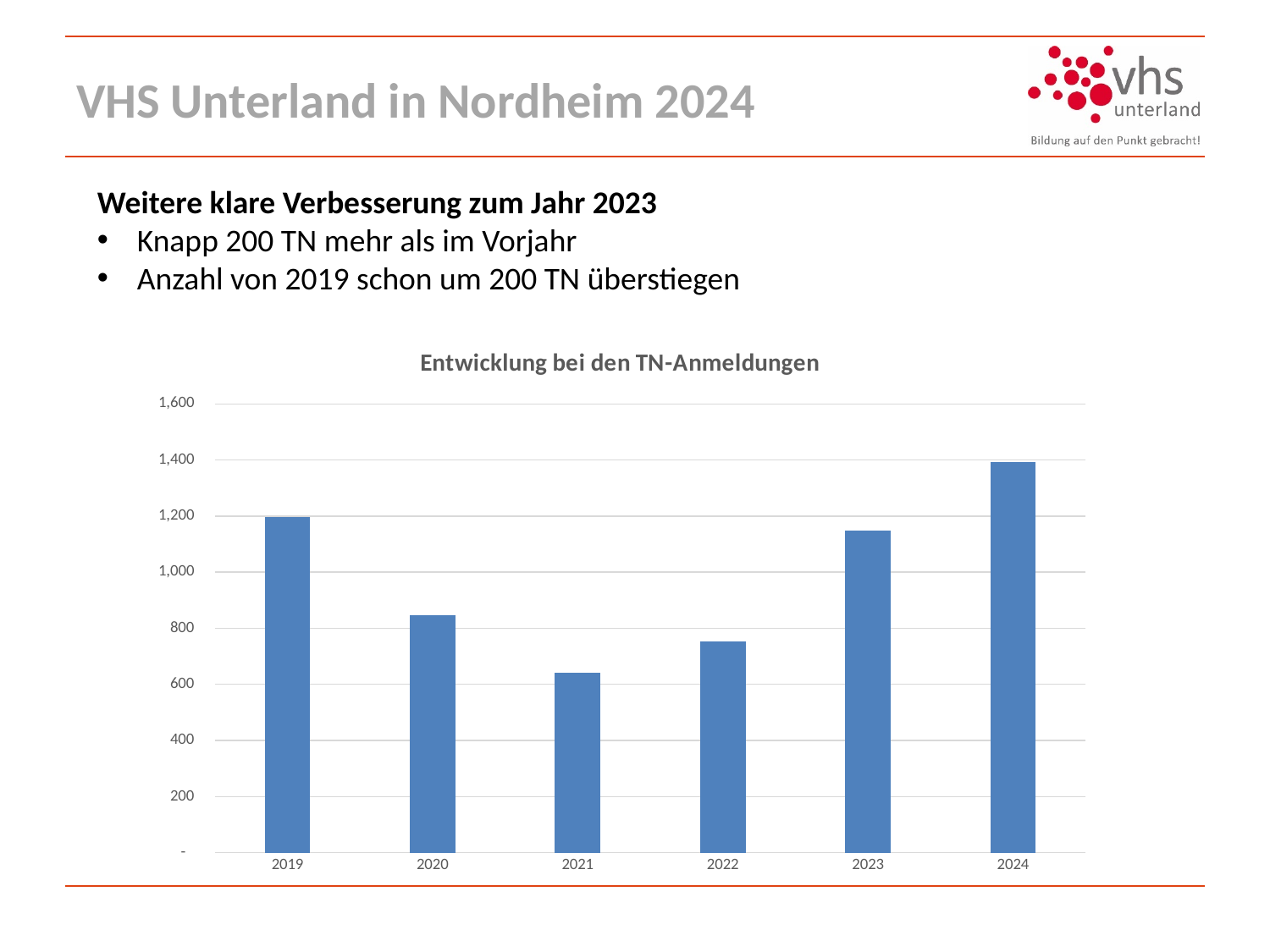
How many years are shown on the x axis of the chart? 6 What is the title of the chart? Entwicklung bei den TN-Anmeldungen Is the value for 2022 greater or less than 800? less Which year has the lowest value in the chart? 2021 Is the value for 2019 greater or less than 1,000? greater Which year has the larger value, 2020 or 2022? 2020 Is the value for 2021 greater or less than 800? less From 2021 to 2024, do the values rise or fall? rise What kind of chart is shown on the slide? bar chart Which year has the highest value in the chart? 2024